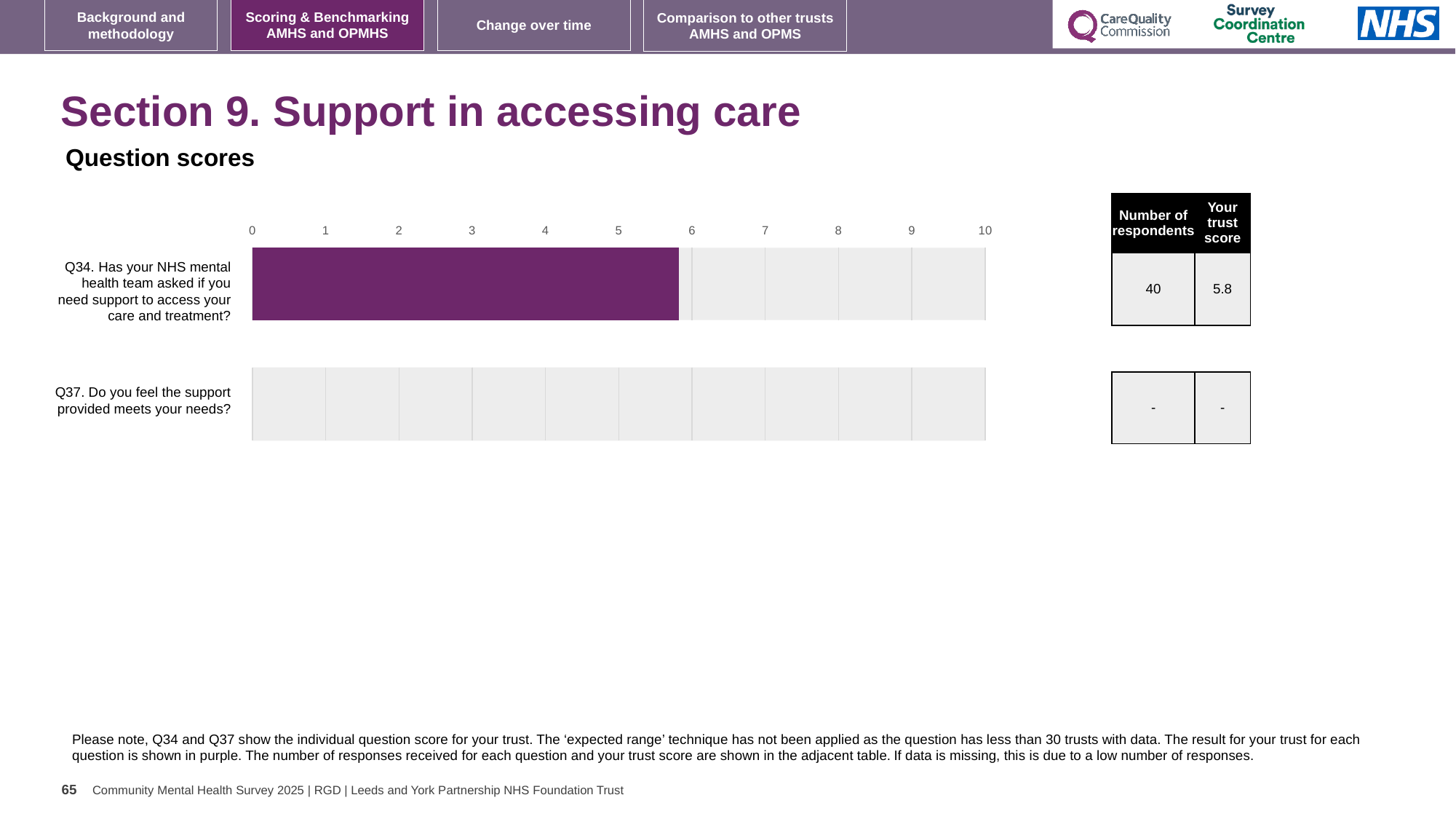
Is the bar for Q34 greater or less than 5 on the axis? greater What is the maximum value shown on the chart's axis? 10 What is the title of the section shown on the slide? Section 9. Support in accessing care What is shown as the trust score for Q37 (Do you feel the support provided meets your needs?)? - What kind of chart is shown on the slide? Bar chart Which question on the chart has a plotted bar? Q34 Is the bar for Q34 greater or less than 6 on the axis? less What is the trust score for Q34 (Has your NHS mental health team asked if you need support to access your care and treatment?)? 5.8 What colour is the bar showing the trust's result for Q34? Purple How many questions are listed on the chart? 2 How many respondents answered Q34? 40